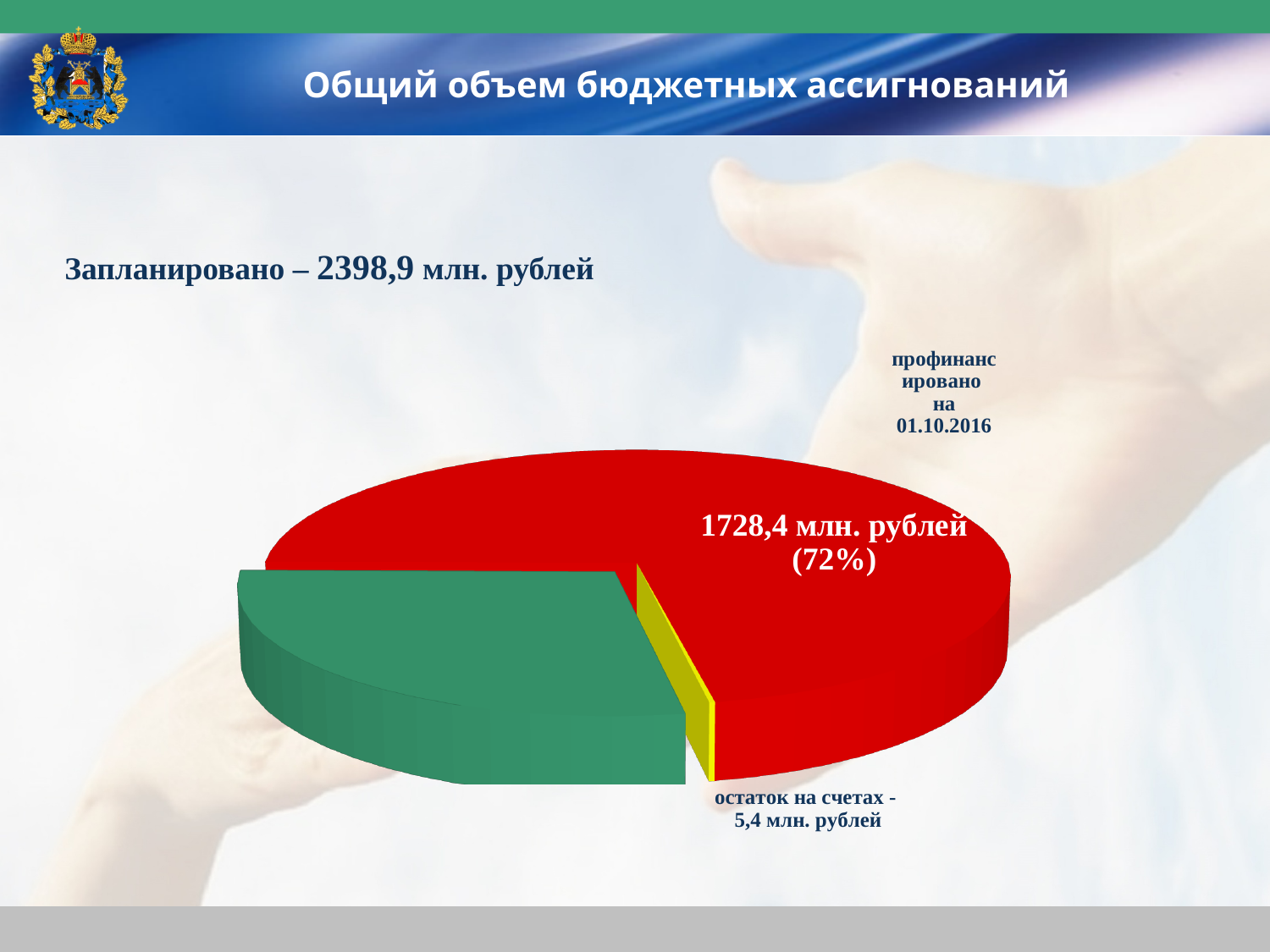
What value is shown for the slice labelled "остаток на счетах"? 5,4 млн. рублей Which slice of the pie chart is the smallest? остаток на счетах Which is larger: the red slice or the green slice? the red slice What value is shown for the slice labelled "профинансировано на 01.10.2016"? 1728,4 млн. рублей How many slices does the pie chart have? 3 What share of the pie does the "профинансировано на 01.10.2016" slice represent? 72% Which is larger: the yellow slice or the green slice? the green slice What is the title of the slide containing the pie chart? Общий объем бюджетных ассигнований What kind of chart is shown on the slide? pie chart Which slice of the pie chart is the largest? профинансировано на 01.10.2016 What colour is the slice labelled "остаток на счетах"? yellow